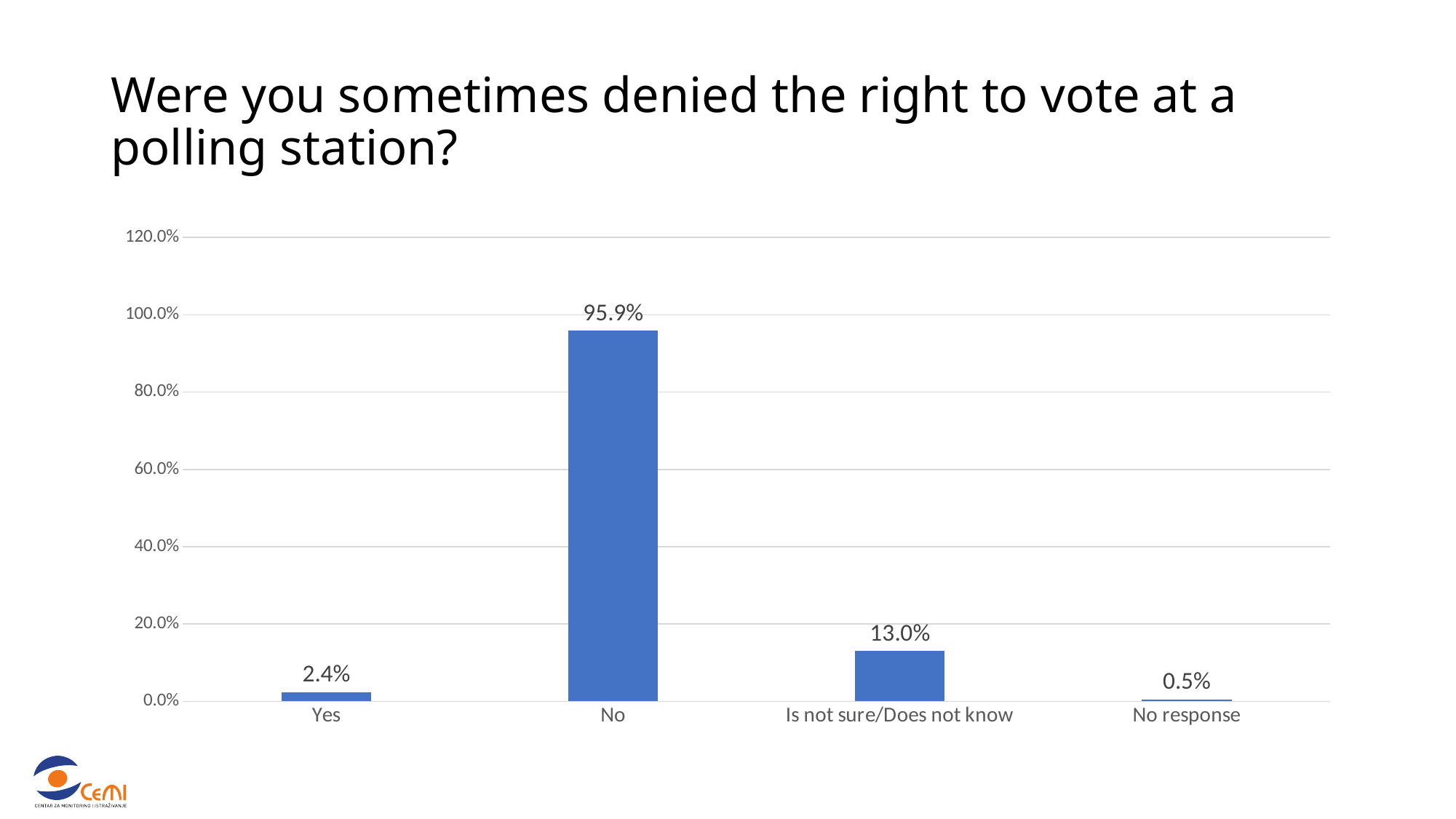
What is the value for "No response"? 0.5% What kind of chart is shown on the slide? Bar chart How many categories are shown on the x axis? 4 Which is larger, the value for "Yes" or the value for "Is not sure/Does not know"? Is not sure/Does not know Is the value for "No" greater or less than 80.0%? greater What is the value for "Yes"? 2.4% Which category has the highest value? No What is the difference between the values for "Yes" and "No response"? 1.9% What is the value for "Is not sure/Does not know"? 13.0% What is the difference between the values for "No" and "Is not sure/Does not know"? 82.9% What is the value for "No"? 95.9% Which category has the lowest value? No response